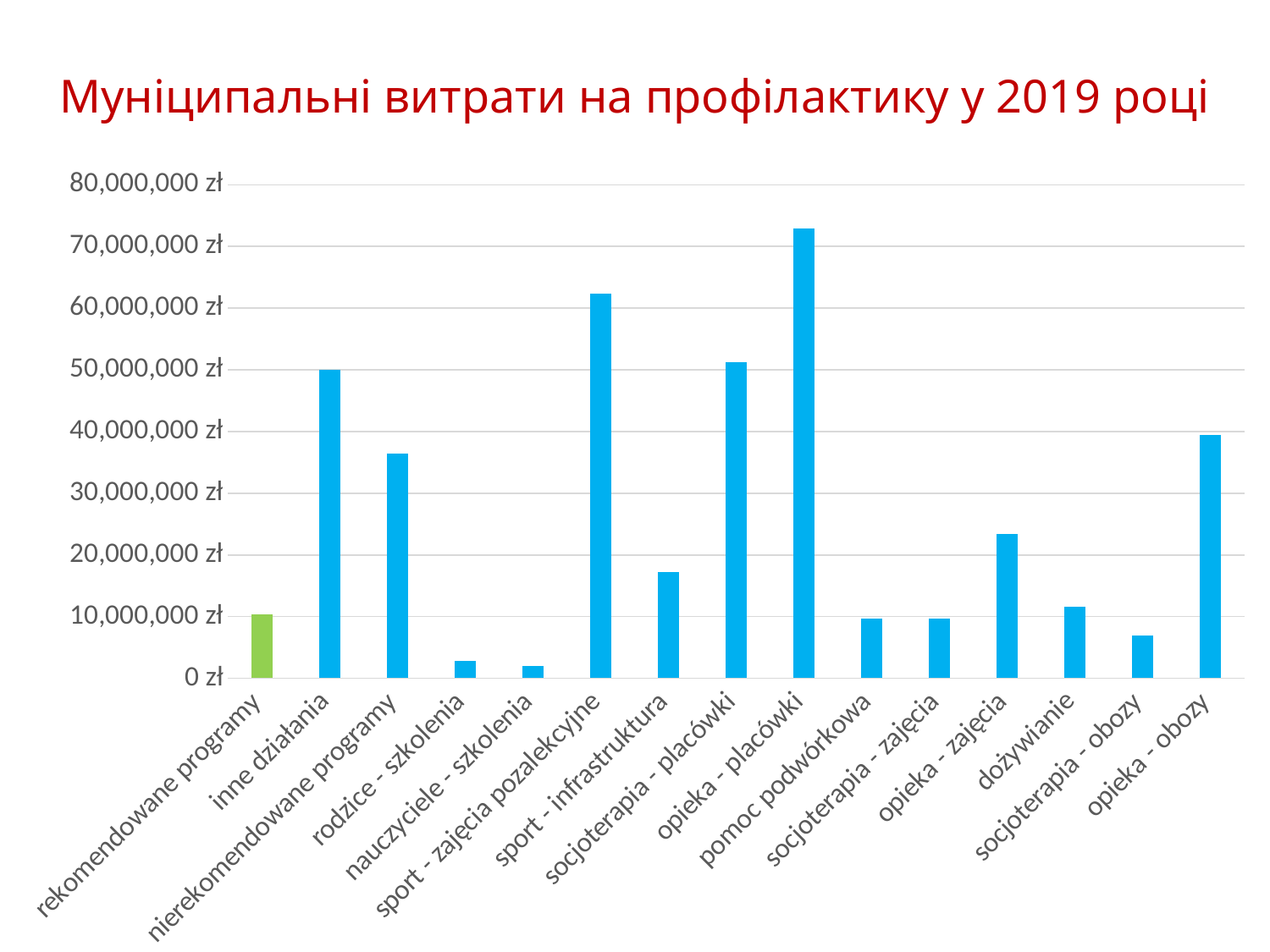
Is the value for socjoterapia - obozy greater or less than 10,000,000 zł? less What kind of chart is shown on the slide? bar chart Is the value for sport - zajęcia pozalekcyjne greater or less than 60,000,000 zł? greater Which category has the highest value? opieka - placówki Is the value for opieka - placówki greater or less than 70,000,000 zł? greater What is the title of the chart? Муніципальні витрати на профілактику у 2019 році Which category is shown with a green bar instead of a blue one? rekomendowane programy Which category has the lowest value? nauczyciele - szkolenia Which is larger, the value for sport - infrastruktura or the value for dożywianie? sport - infrastruktura How many categories are plotted on the chart? 15